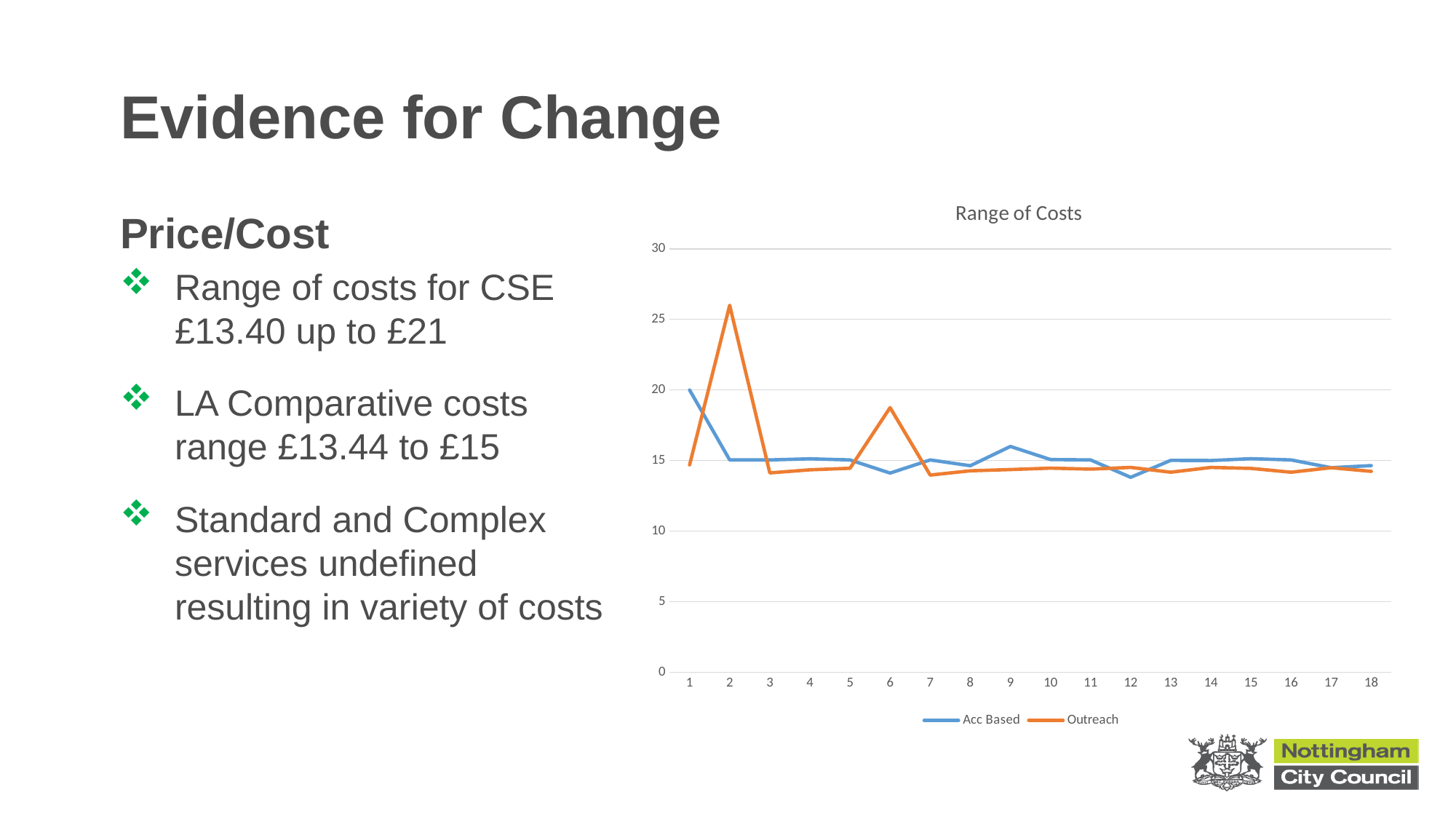
How many series does the chart legend list? 2 At which x-axis point does the Acc Based series reach its highest value? 1 At point 1, which series has the larger value, Acc Based or Outreach? Acc Based At which x-axis point does the Outreach series reach its highest value? 2 Which series is drawn in orange? Outreach What kind of chart is shown on the slide? line chart At point 2, which series has the larger value, Acc Based or Outreach? Outreach Is the Acc Based value at point 1 greater or less than 15? greater What is the title of the chart? Range of Costs Is the Outreach value at point 2 greater or less than 25? greater How many points are plotted along the x axis for each series? 18 Is the Outreach value at point 6 greater or less than 20? less